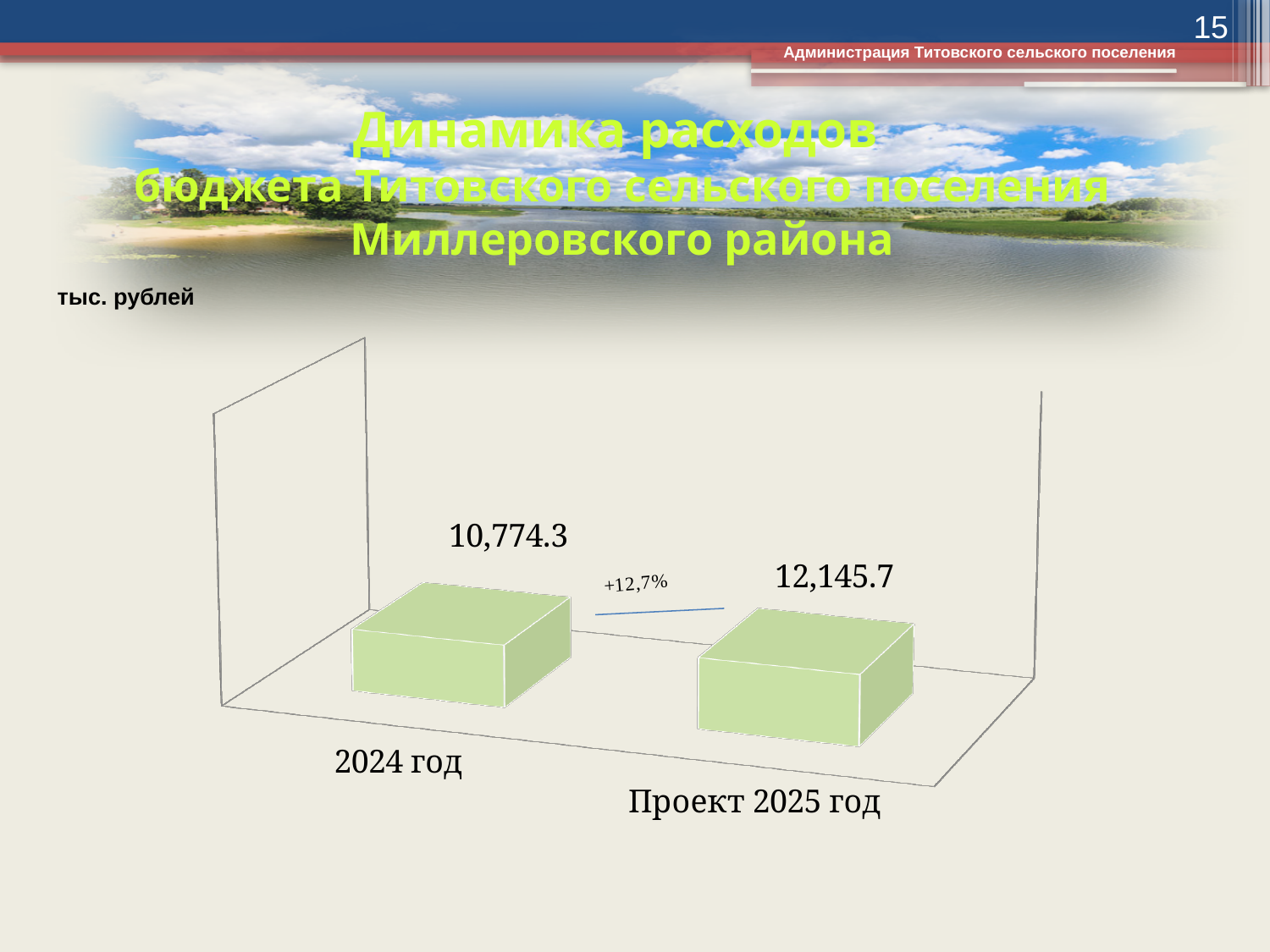
What is the value shown for 2024 год? 10,774.3 What kind of chart is shown on the slide? Bar chart What percentage change is annotated between the two bars? +12,7% Which is larger, the value for 2024 год or the value for Проект 2025 год? Проект 2025 год What is the value shown for Проект 2025 год? 12,145.7 How many categories are plotted in the chart? 2 Which category has the lowest value? 2024 год In what units are the chart values expressed, according to the label above the chart? тыс. рублей What is the difference between the values for Проект 2025 год and 2024 год? 1,371.4 Which category has the highest value? Проект 2025 год Do the values rise or fall from 2024 год to Проект 2025 год? Rise